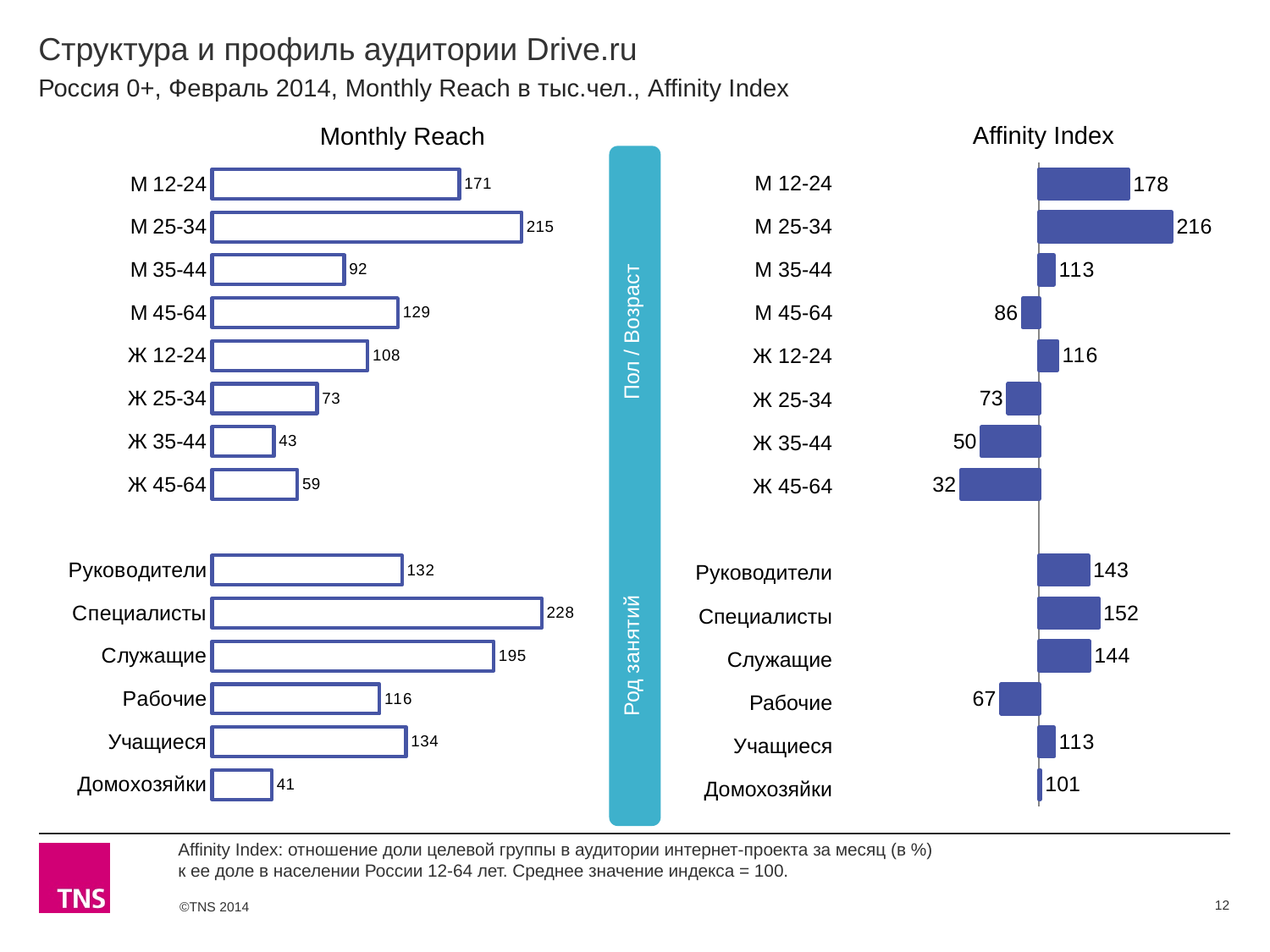
In the Monthly Reach chart, which category has the highest value? Специалисты In the Monthly Reach chart, which is larger: Ж 12-24 or М 35-44? Ж 12-24 In the Affinity Index chart, which category has the lowest value? Ж 45-64 How many categories are plotted in the Affinity Index chart? 14 In the Affinity Index chart, what is the value for Ж 45-64? 32 In the Monthly Reach chart, which category has the lowest value? Домохозяйки In the Affinity Index chart, what is the difference between М 25-34 and М 12-24? 38 What type of chart is the Monthly Reach chart? Bar chart In the Affinity Index chart, which is larger: Руководители or Служащие? Служащие In the Monthly Reach chart, what is the value for М 25-34? 215 In the Monthly Reach chart, what is the difference between Специалисты and Служащие? 33 In the Affinity Index chart, what is the value for Рабочие? 67